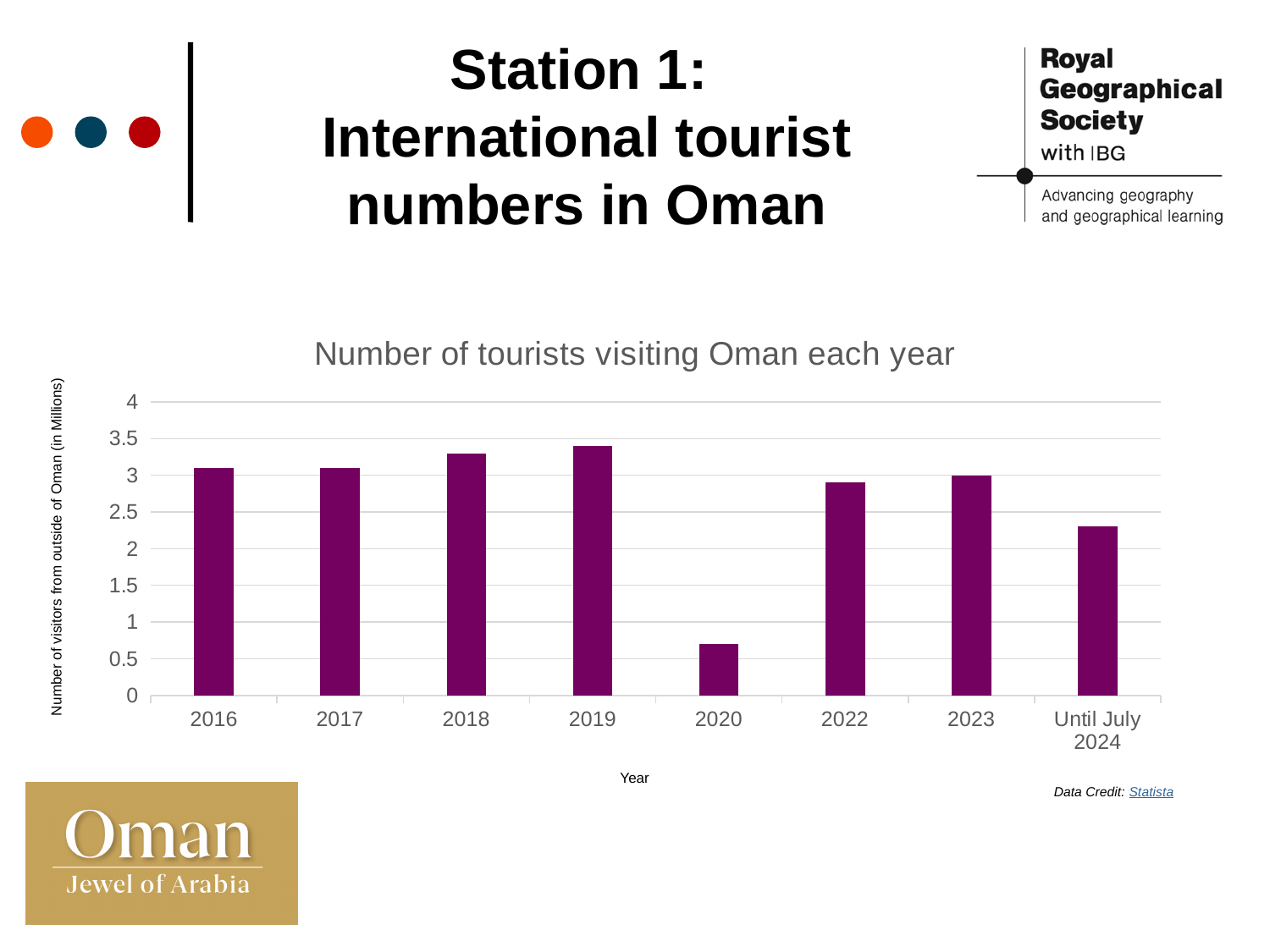
Is the value for Until July 2024 greater or less than 2.5? less What is the label of the y axis of the chart? Number of visitors from outside of Oman (in Millions) Is the value for 2018 greater or less than 3? greater Which year has the lowest number of tourists visiting Oman? 2020 Which is larger, the value for 2023 or the value for Until July 2024? 2023 Is the value for 2019 greater or less than 3? greater How many years (categories) are shown on the x axis of the chart? 8 What kind of chart is shown on the slide? bar chart Which year has the highest number of tourists visiting Oman? 2019 Which is larger, the value for 2018 or the value for 2022? 2018 What is the title of the chart? Number of tourists visiting Oman each year